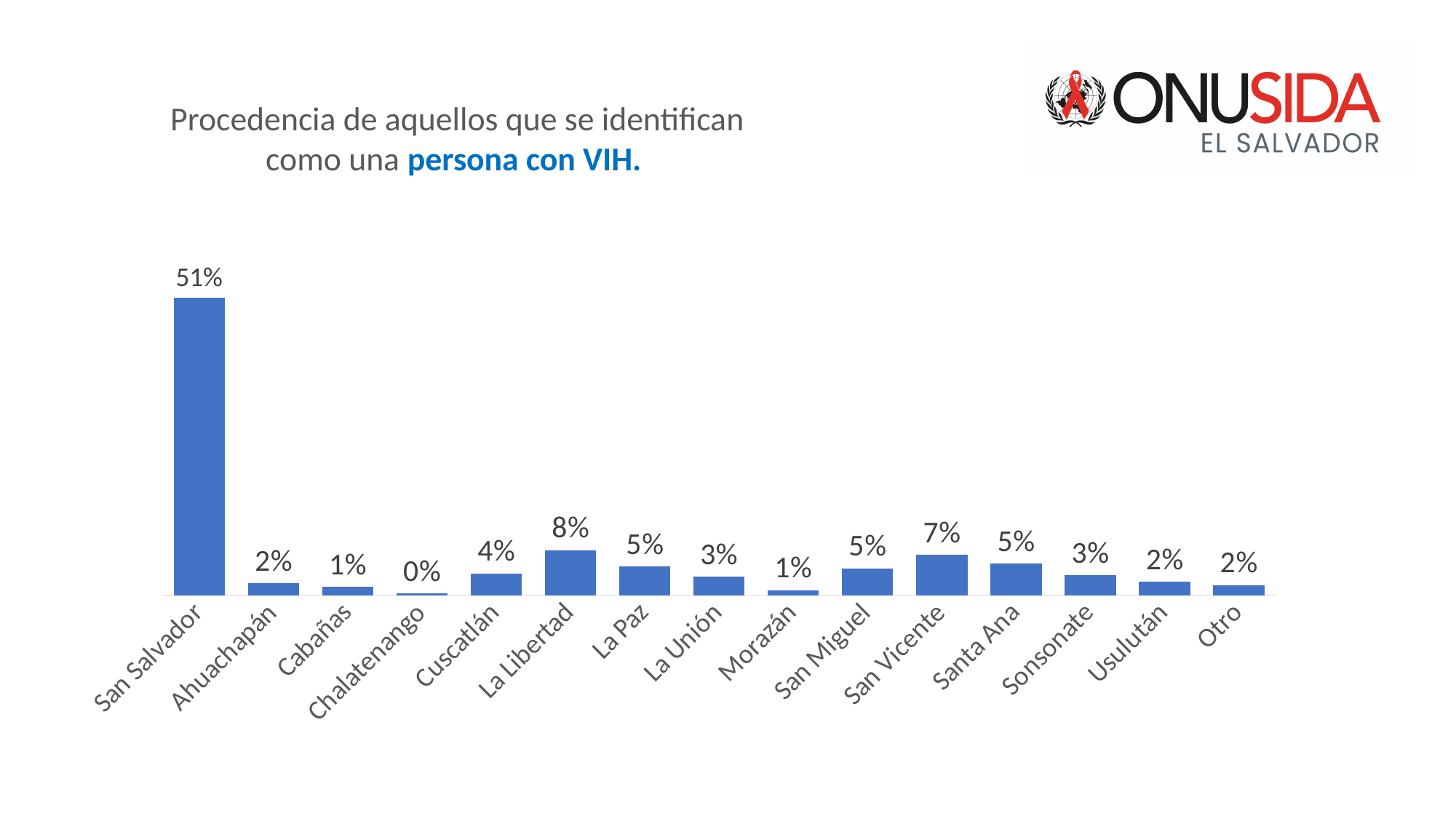
What kind of chart is shown on the slide? Bar chart What is the value for La Libertad? 8% What is the title of the chart? Procedencia de aquellos que se identifican como una persona con VIH. What is the difference between the values for San Vicente and Morazán? 6% Which is larger, the value for Cuscatlán or the value for Sonsonate? Cuscatlán What is the value for San Salvador? 51% Which category has the highest value? San Salvador How many categories are shown on the x axis? 15 What is the difference between the values for San Salvador and La Libertad? 43% Which category has the lowest value? Chalatenango What is the value for Chalatenango? 0% What is the value for San Vicente? 7%